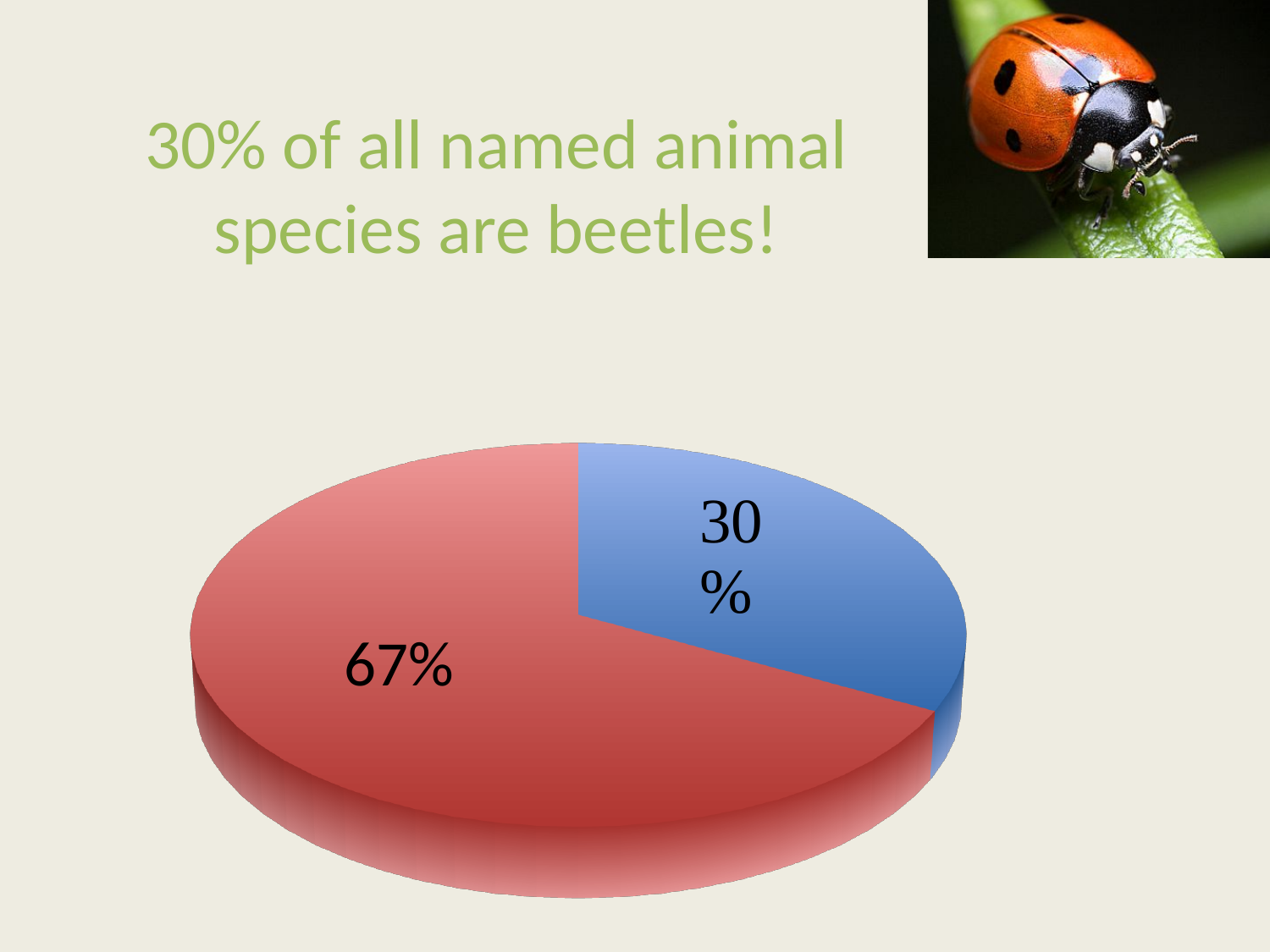
Which slice is larger, the blue slice or the red slice? the red slice How many slices does the pie chart have? 2 What value is printed on the red slice of the pie chart? 67% Does the pie chart have a legend? No What share of the pie does the blue slice represent, according to its label? 30% What colours are the two slices of the pie chart? blue and red Is the value of the red slice greater or less than 50%? greater What is the difference between the values printed on the red slice and the blue slice? 37% Which slice of the pie chart is the largest? the red slice (67%) What kind of chart is shown on the slide? pie chart Which slice of the pie chart is the smallest? the blue slice (30%) What value is printed on the blue slice of the pie chart? 30%